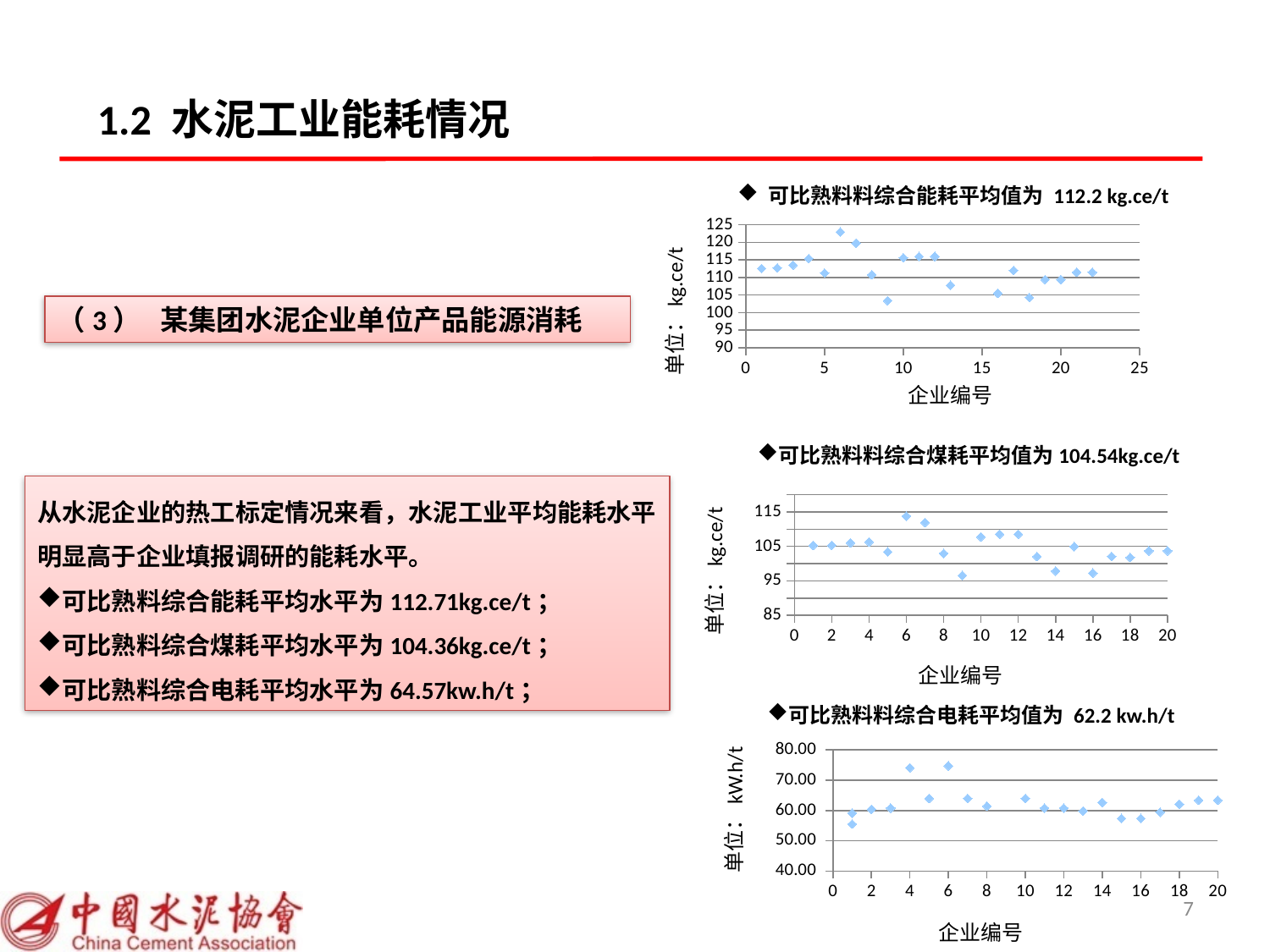
In the bottom chart (可比熟料料综合电耗), is the value for enterprise 1 greater or less than 60.00? less In the top chart (可比熟料料综合能耗), which has the larger value, enterprise 6 or enterprise 9? enterprise 6 In the middle chart (可比熟料料综合煤耗), is the value for enterprise 9 greater or less than 100? less According to the title of the bottom chart, what is the average value of 可比熟料料综合电耗? 62.2 kw.h/t In the top chart (可比熟料料综合能耗), is the value for enterprise 9 greater or less than 105? less In the middle chart (可比熟料料综合煤耗), which enterprise number has the highest value? 6 How many data points are plotted in the middle chart (可比熟料料综合煤耗)? 20 In the top chart (可比熟料料综合能耗), which enterprise number has the highest value? 6 What kind of chart is the top chart on the slide (可比熟料料综合能耗)? scatter chart